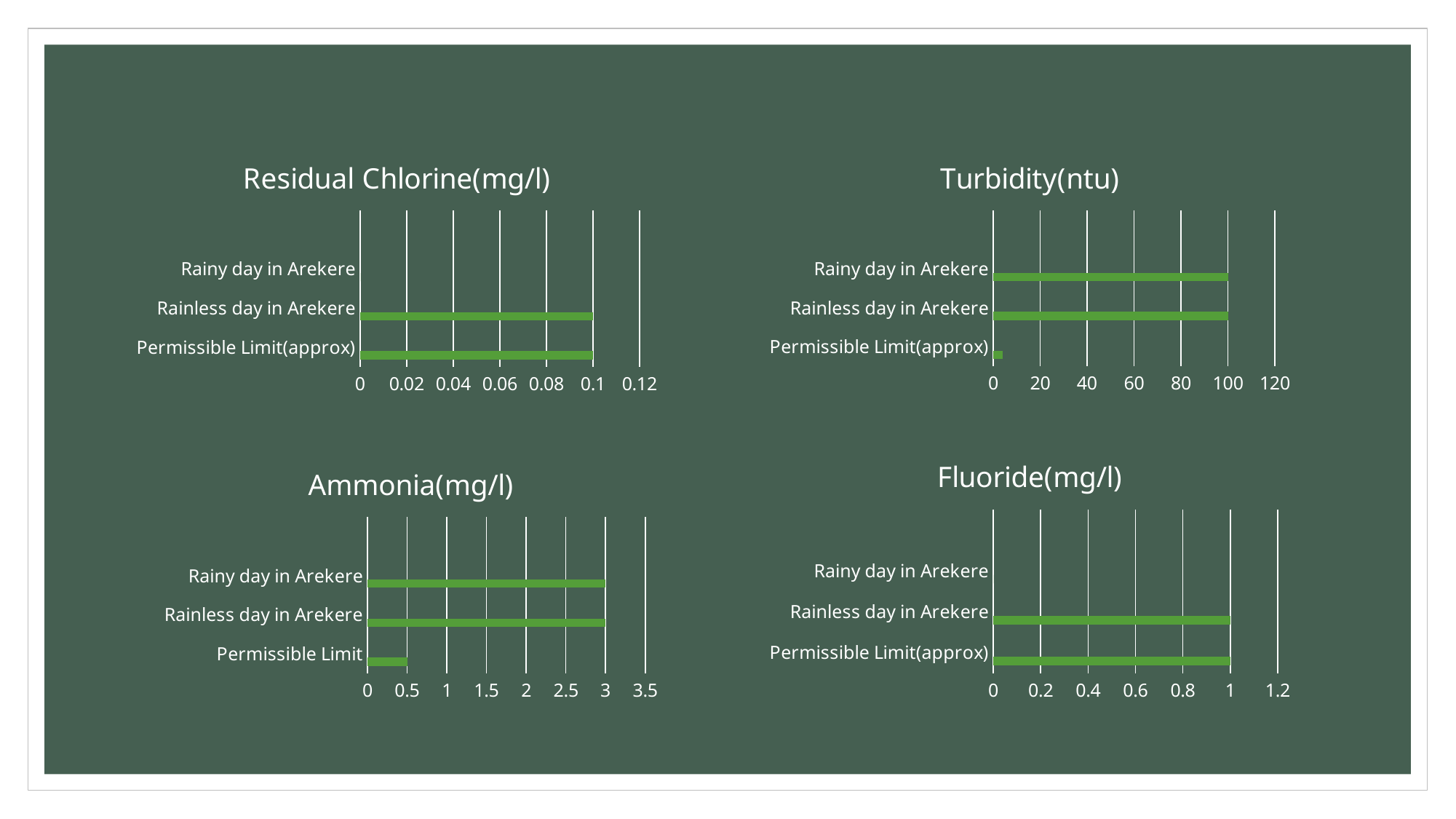
In the Ammonia(mg/l) chart, what is the difference between Rainless day in Arekere and Permissible Limit? 2.5 In the Residual Chlorine(mg/l) chart, what is the value for Rainless day in Arekere? 0.1 In the Residual Chlorine(mg/l) chart, what is the value for Permissible Limit(approx)? 0.1 How many charts are shown on the slide? 4 In the Turbidity(ntu) chart, is the value for Permissible Limit(approx) greater or less than 20? less What kind of chart is the Fluoride(mg/l) chart? bar chart In the Fluoride(mg/l) chart, what is the value for Rainless day in Arekere? 1 In the Turbidity(ntu) chart, what is the value for Rainy day in Arekere? 100 In the Turbidity(ntu) chart, which category has the lowest value? Permissible Limit(approx) In the Ammonia(mg/l) chart, what is the value for Permissible Limit? 0.5 In the Ammonia(mg/l) chart, what is the value for Rainy day in Arekere? 3 In the Ammonia(mg/l) chart, which is larger, Rainy day in Arekere or Permissible Limit? Rainy day in Arekere